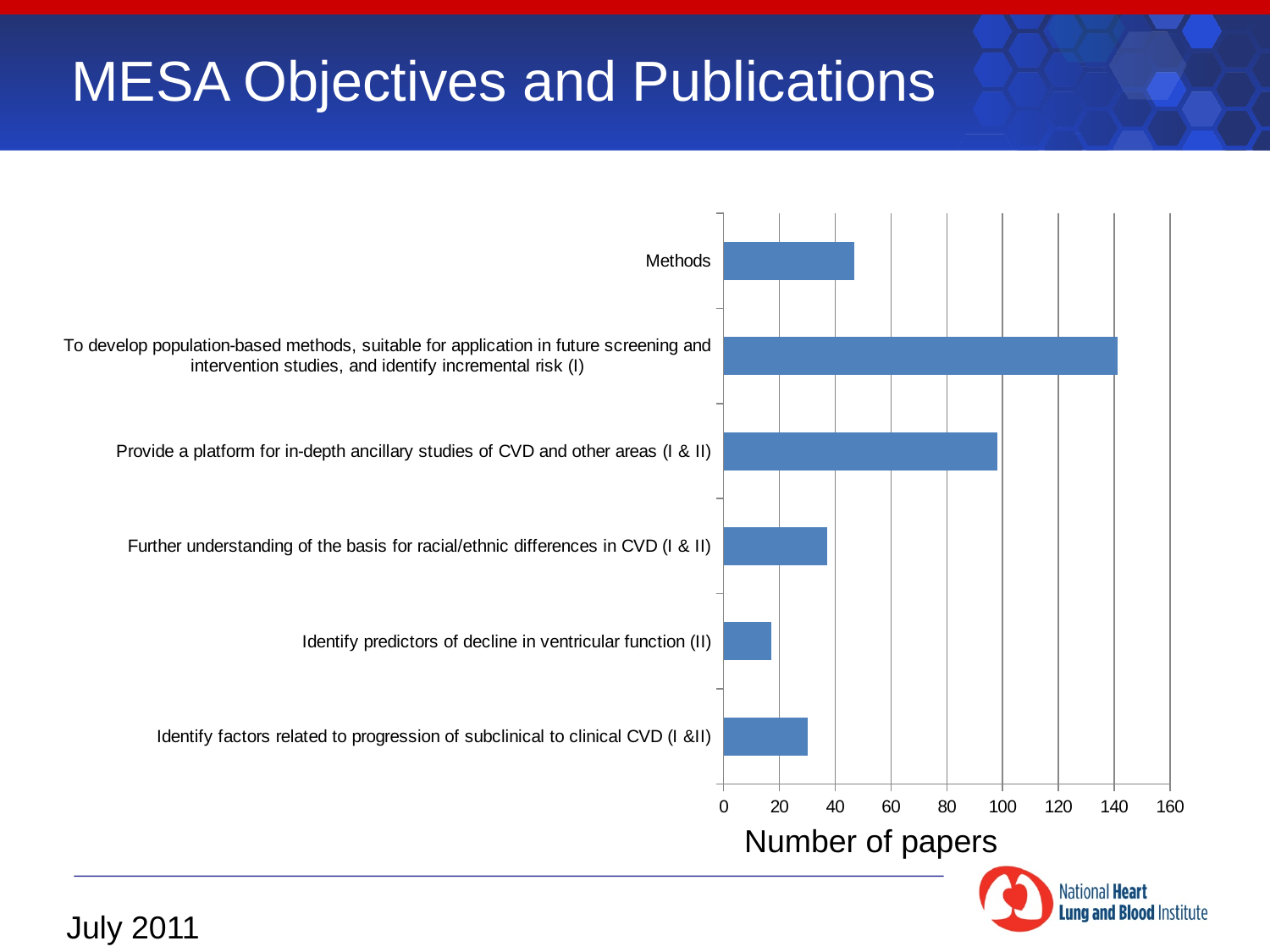
Is the number of papers for 'To develop population-based methods, suitable for application in future screening and intervention studies, and identify incremental risk (I)' greater or less than 120? greater Which has more papers: 'Methods' or 'Further understanding of the basis for racial/ethnic differences in CVD (I & II)'? Methods Is the number of papers for 'Identify factors related to progression of subclinical to clinical CVD (I &II)' greater or less than 20? greater Which category has the lowest number of papers? Identify predictors of decline in ventricular function (II) Which has more papers: 'Provide a platform for in-depth ancillary studies of CVD and other areas (I & II)' or 'Identify factors related to progression of subclinical to clinical CVD (I &II)'? Provide a platform for in-depth ancillary studies of CVD and other areas (I & II) Which category has the highest number of papers? To develop population-based methods, suitable for application in future screening and intervention studies, and identify incremental risk (I) Is the number of papers for 'Methods' greater or less than 40? greater How many objectives (categories) are plotted in the chart? 6 What kind of chart is shown on the slide? bar chart What is the title of the horizontal axis of the chart? Number of papers